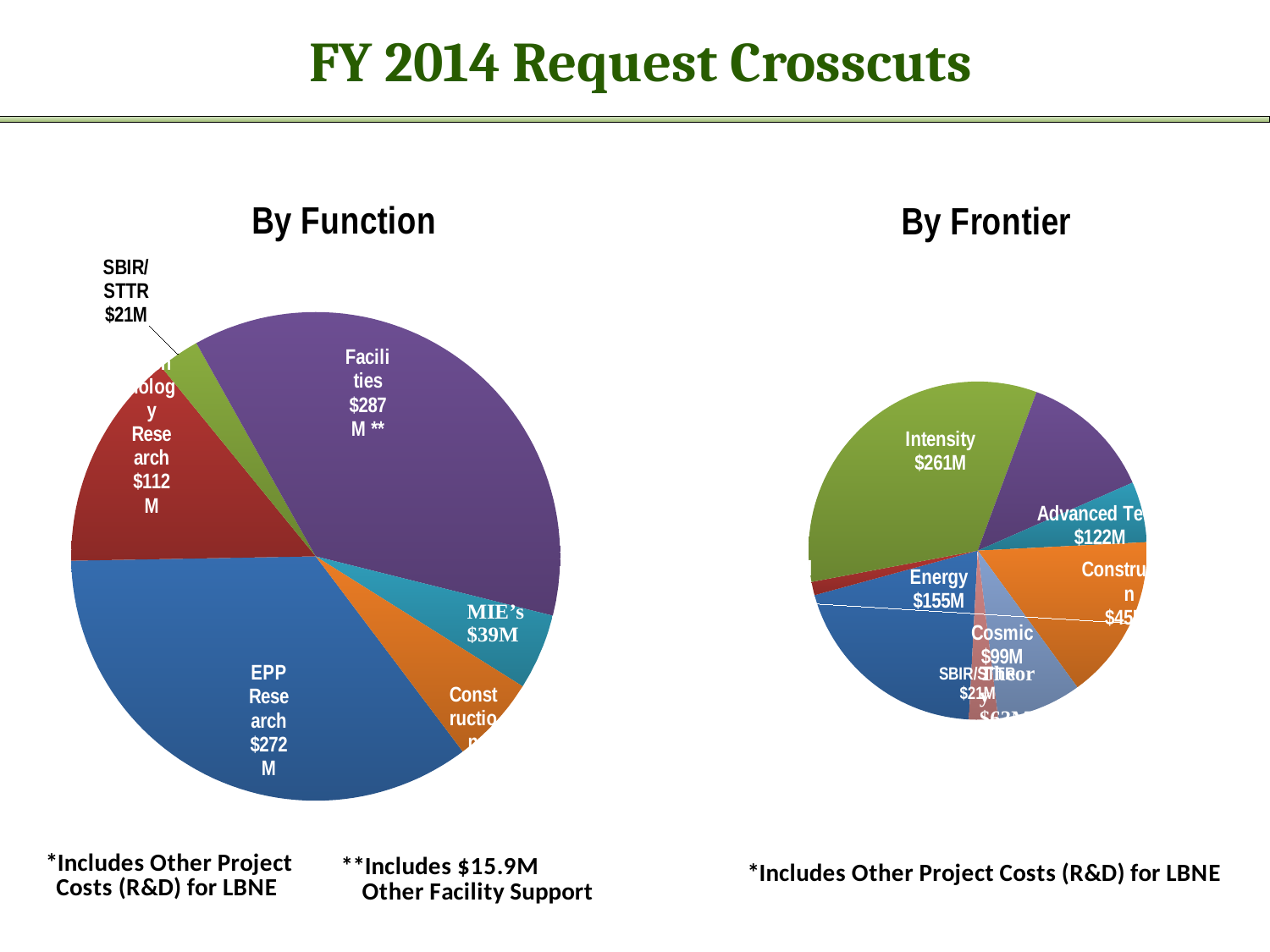
In the By Function pie chart, which category has the largest slice? Facilities In the By Frontier pie chart, which category has the largest slice? Intensity In the By Function pie chart, what is the value for SBIR/STTR? $21M In the By Function pie chart, what is the value for EPP Research? $272M In the By Function pie chart, what is the difference between Facilities and EPP Research? $15M What kind of chart is the By Function chart? Pie chart In the By Function pie chart, what is the value for MIE's? $39M In the By Function pie chart, what is the value for Facilities? $287M In the By Function pie chart, which is larger: EPP Research or Technology Research? EPP Research In the By Frontier pie chart, what is the value for Intensity? $261M In the By Frontier pie chart, what is the value for Energy? $155M In the By Frontier pie chart, what is the difference between Intensity and Energy? $106M